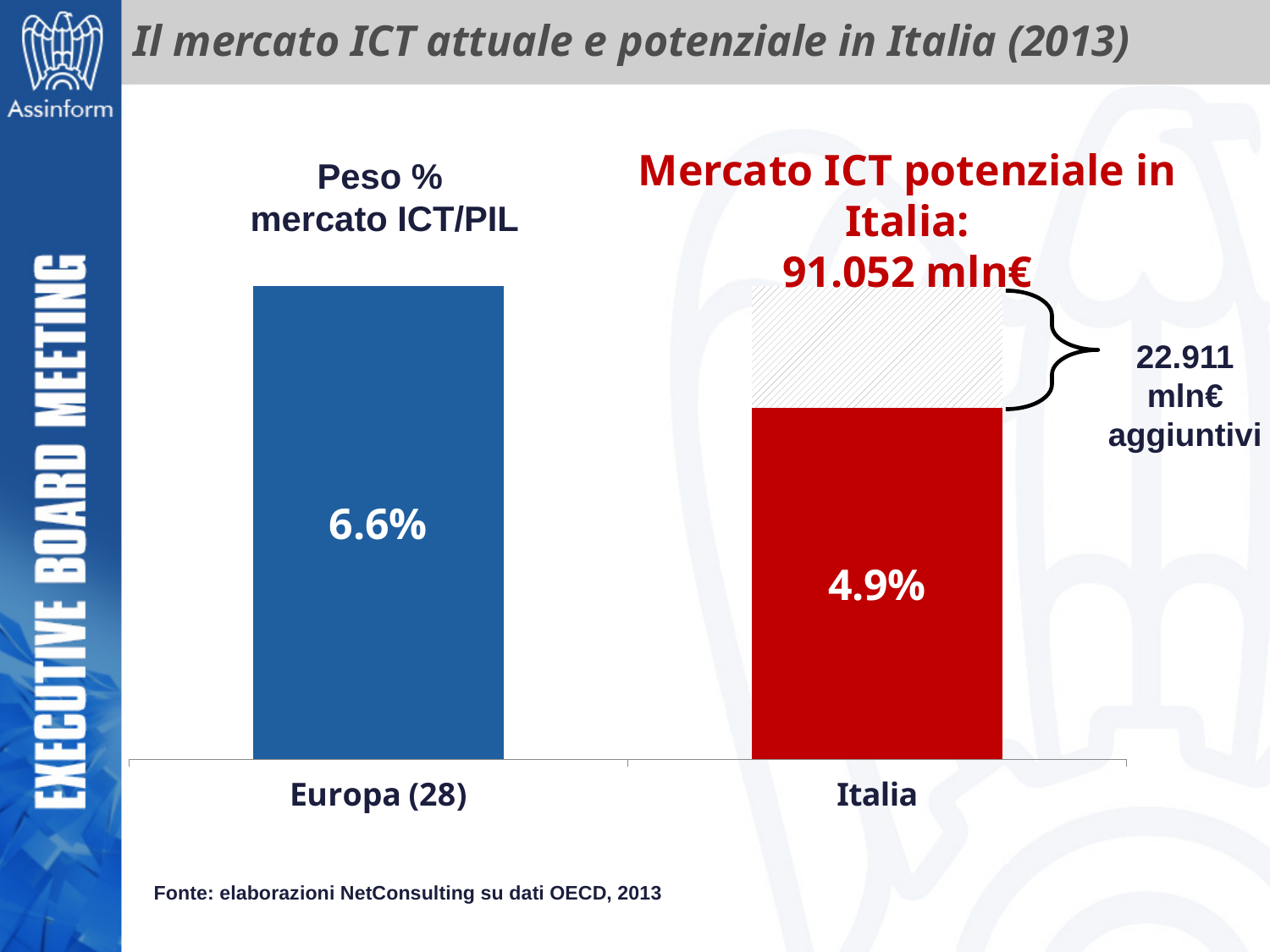
Which category has the highest value? Europa (28) What colour is the bar for Italia? Red Which category has the lowest value? Italia What is the title of the chart? Peso % mercato ICT/PIL How many categories are shown in the chart? 2 According to the annotation on the chart, what is the potential ICT market in Italy? 91.052 mln€ According to the annotation next to the hatched area, how many additional mln€ are indicated? 22.911 mln€ What kind of chart is shown on the slide? Bar chart What is the value shown for Italia? 4.9% What is the value shown for Europa (28)? 6.6% What is the difference between the values for Europa (28) and Italia? 1.7% Which is larger, the value for Europa (28) or the value for Italia? Europa (28)